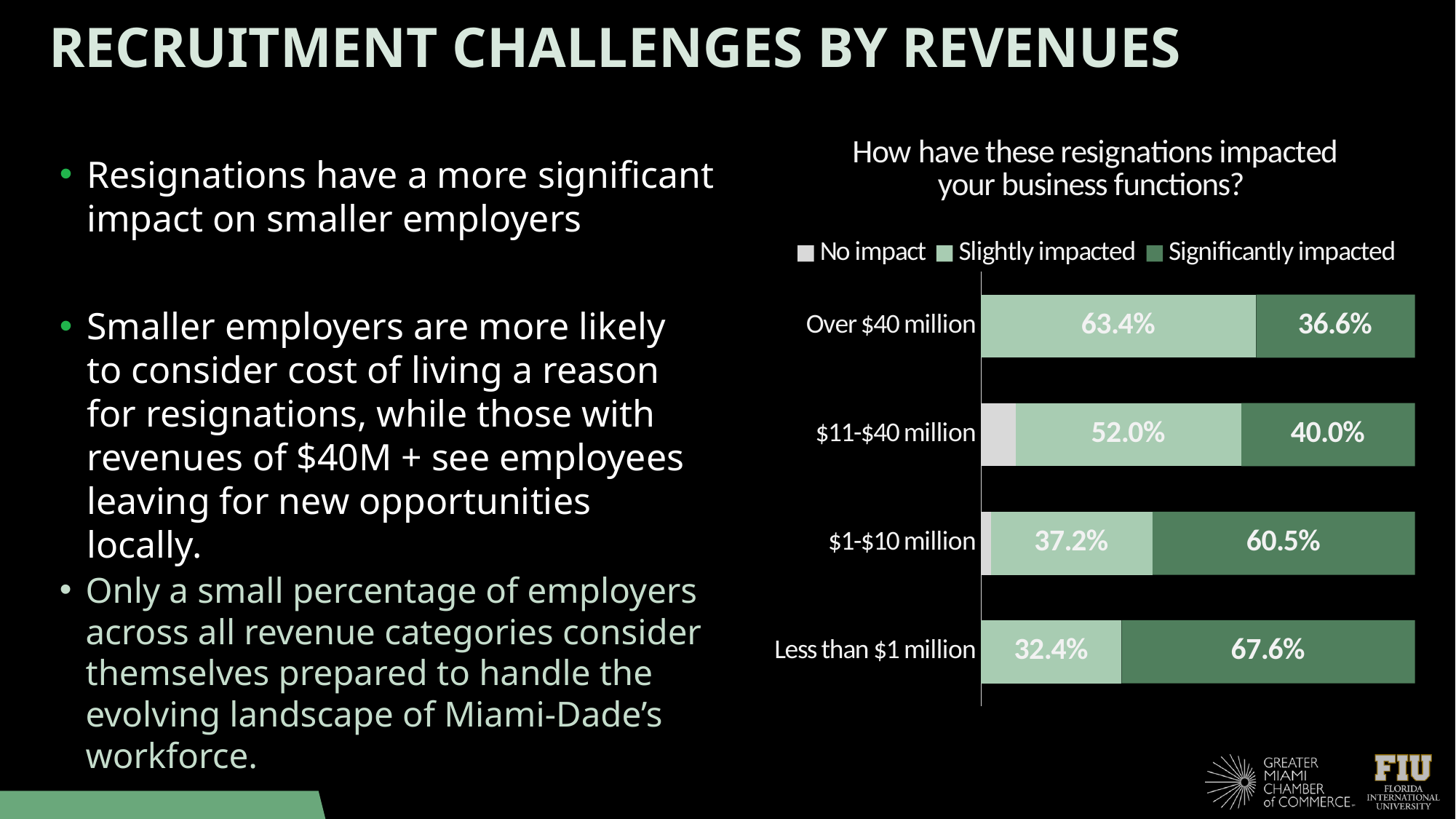
What type of chart is used to show how resignations impacted business functions? Stacked bar chart Which is larger for the $1-$10 million category: the 'Slightly impacted' share or the 'Significantly impacted' share? Significantly impacted How many revenue categories are shown in the chart? 4 What percentage of employers with revenues of less than $1 million reported being significantly impacted? 67.6% What is the difference between the 'Significantly impacted' percentages for the Less than $1 million and Over $40 million categories? 31.0% What is the 'Slightly impacted' value for the $1-$10 million revenue category? 37.2% Which revenue category has the lowest 'Slightly impacted' percentage? Less than $1 million What is the title of the chart on the slide? How have these resignations impacted your business functions? What percentage of employers with revenues over $40 million reported being slightly impacted by resignations? 63.4% How many series does the chart legend list? 3 What is the 'Significantly impacted' value for the $11-$40 million revenue category? 40.0% Which revenue category has the highest 'Significantly impacted' percentage? Less than $1 million